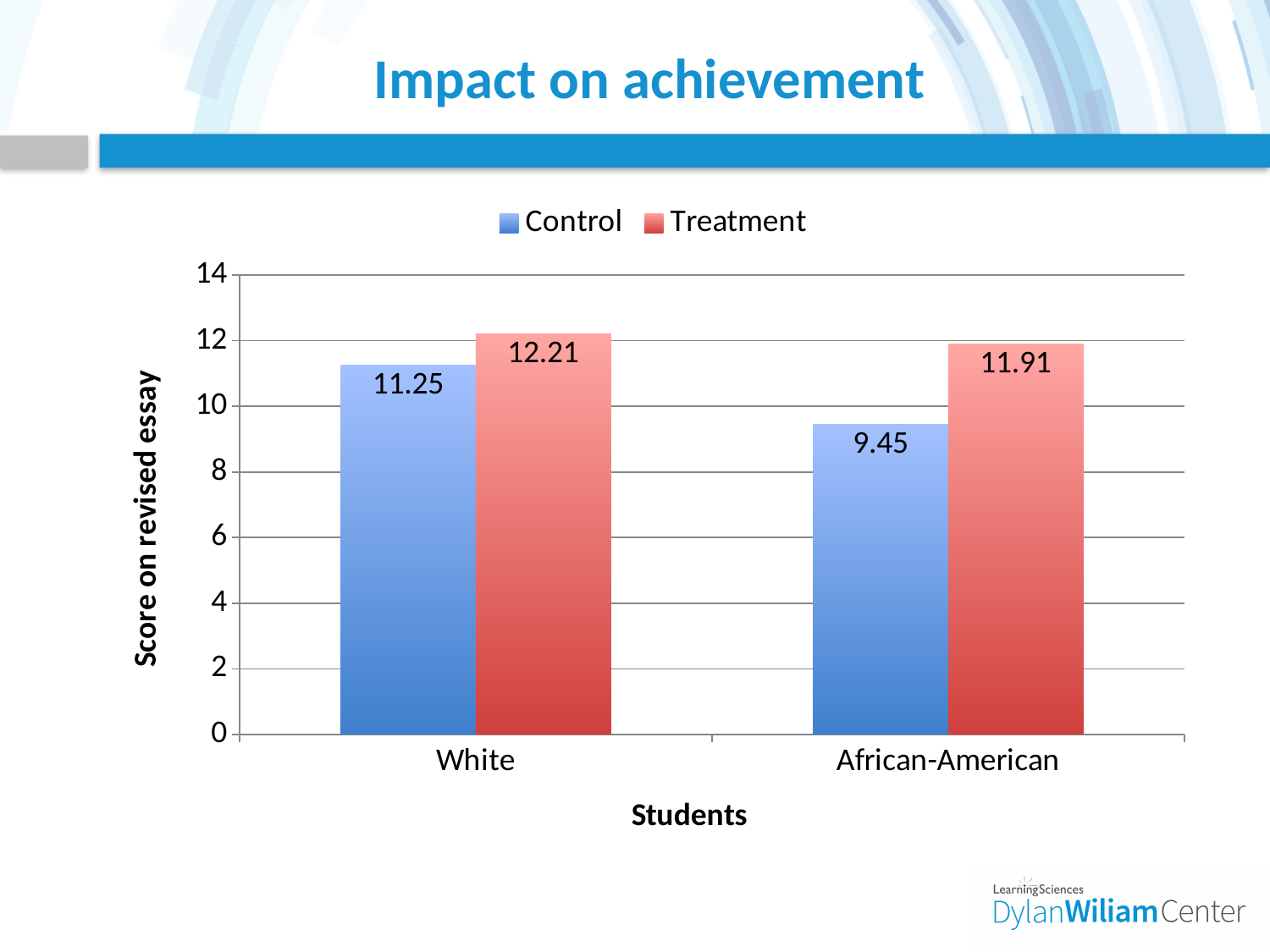
What kind of chart is shown on the slide? Bar chart What is the Treatment score for White students? 12.21 What is the Treatment score for African-American students? 11.91 Which is larger: the Control score for White students or the Treatment score for African-American students? Treatment score for African-American students How many student categories are shown on the x axis? 2 What is the difference between the Treatment and Control scores for White students? 0.96 What is the difference between the Treatment and Control scores for African-American students? 2.46 Which bar has the lowest value on the chart? Control, African-American What is the Control score for White students? 11.25 How many series does the legend list? 2 What is the Control score for African-American students? 9.45 Which bar has the highest value on the chart? Treatment, White